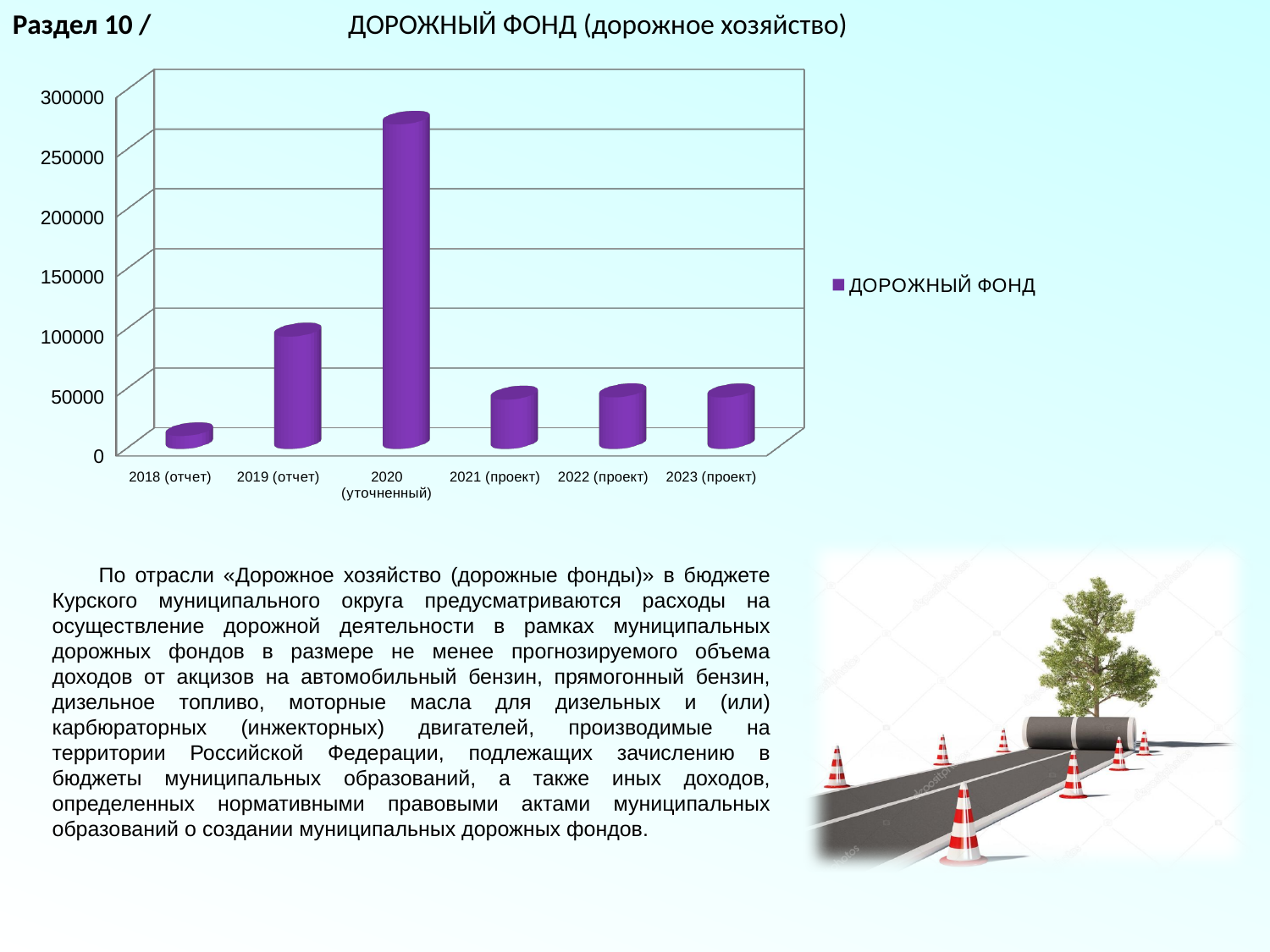
How many categories are plotted on the x axis of the chart? 6 What kind of chart is shown on the slide? bar chart Is the value for 2020 (уточненный) greater or less than 250000? greater Is the value for 2019 (отчет) greater or less than 50000? greater Which category has the highest value in the chart? 2020 (уточненный) Which category has the lowest value in the chart? 2018 (отчет) Which is larger, the value for 2019 (отчет) or the value for 2021 (проект)? 2019 (отчет) Is the value for 2018 (отчет) greater or less than 50000? less What series name is shown in the chart legend? ДОРОЖНЫЙ ФОНД How many series does the chart legend list? 1 Do the values rise or fall from 2018 (отчет) to 2020 (уточненный)? rise